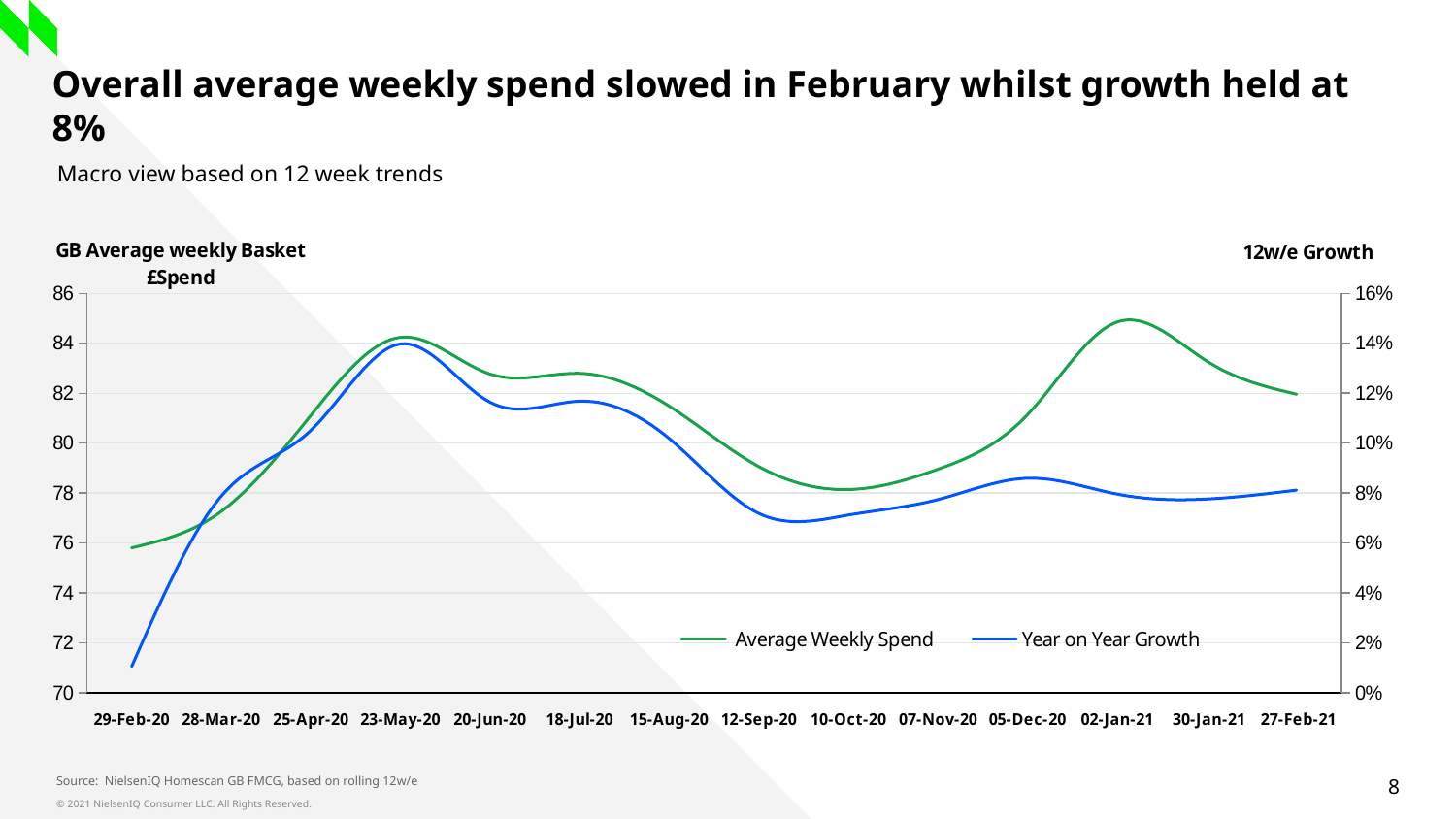
At which date does the Average Weekly Spend line reach its highest point? 02-Jan-21 Which colour is used for the Average Weekly Spend line? Green Does the Average Weekly Spend line rise or fall between 23-May-20 and 10-Oct-20? Fall Is the Year on Year Growth value at 10-Oct-20 greater or less than 8%? less At which date is the Average Weekly Spend line at its lowest? 29-Feb-20 How many dates are labelled along the x axis of the chart? 14 How many series does the chart legend list? 2 At which date does the Year on Year Growth line reach its highest point? 23-May-20 What kind of chart is shown on the slide? Line chart Is the Year on Year Growth value at 23-May-20 greater or less than 12%? greater Is the Average Weekly Spend value at 29-Feb-20 greater or less than 78? less At which date is the Year on Year Growth line at its lowest? 29-Feb-20